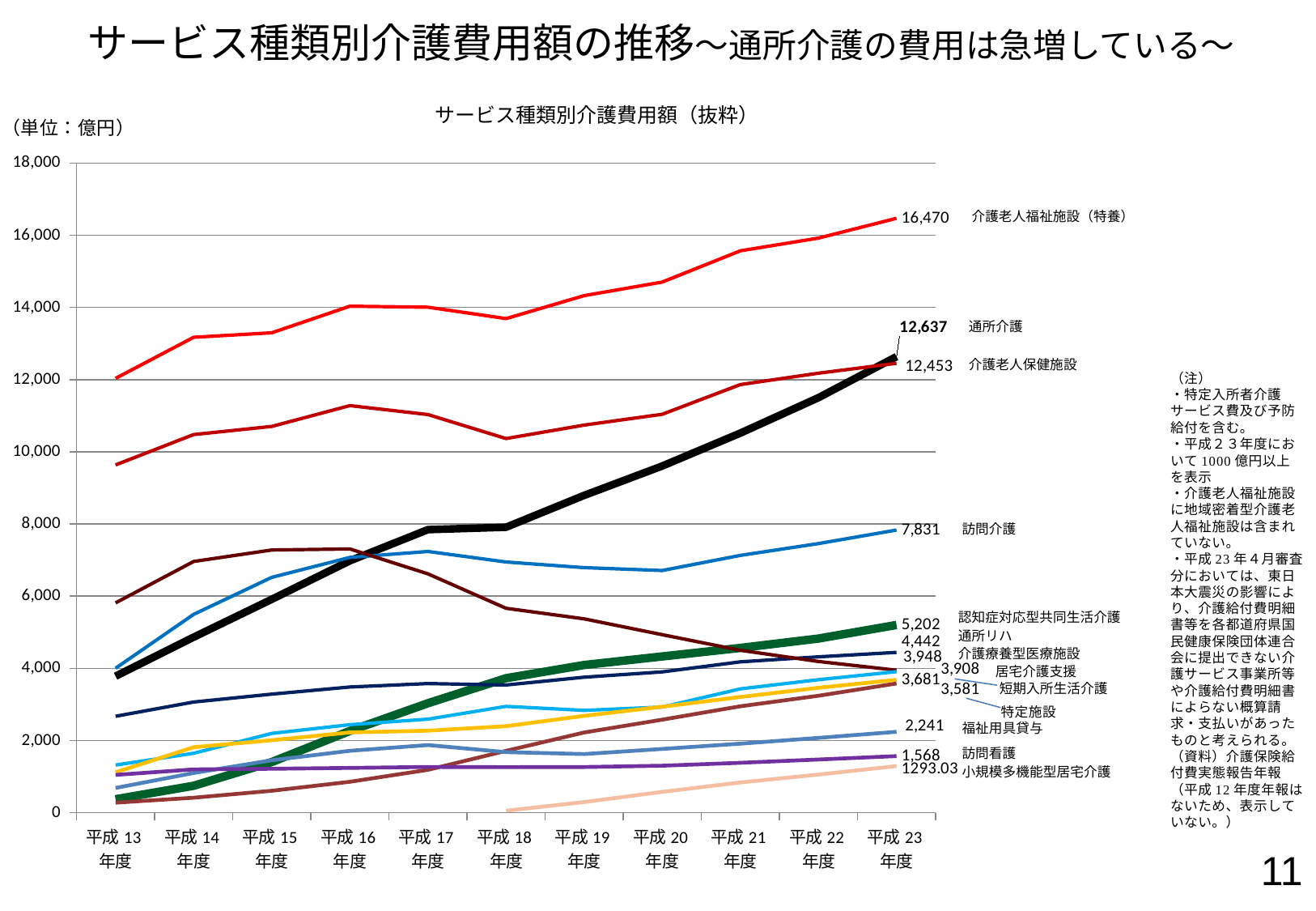
Does the value for 通所介護 rise or fall from 平成13年度 to 平成23年度? rise What is the value for 訪問介護 in 平成23年度? 7,831 Which service has the highest value in 平成23年度? 介護老人福祉施設（特養） Which is larger in 平成23年度, 認知症対応型共同生活介護 or 通所リハ? 認知症対応型共同生活介護 What is the value for 通所介護 in 平成23年度? 12,637 Is the value for 介護老人保健施設 in 平成13年度 greater or less than 10,000? less What is the value for 介護老人福祉施設（特養） in 平成23年度? 16,470 How many fiscal years are shown on the x axis? 11 What kind of chart is shown on the slide? line chart What is the difference between 通所介護 and 介護老人保健施設 in 平成23年度? 184 What is the difference between 介護老人福祉施設（特養） and 通所介護 in 平成23年度? 3,833 What is the value for 福祉用具貸与 in 平成23年度? 2,241